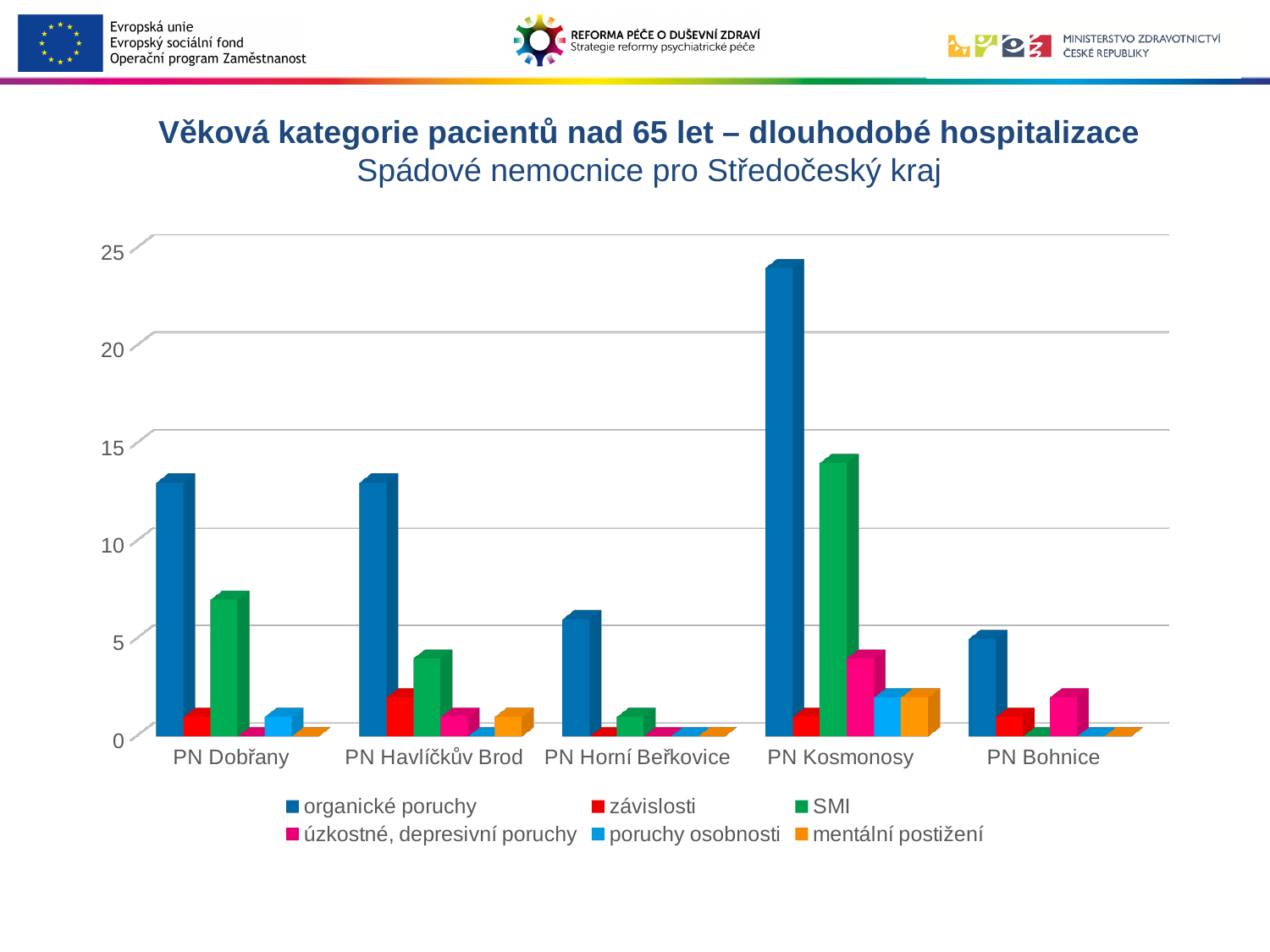
Is the value for organické poruchy at PN Dobřany greater or less than 10? greater What is the main title of the chart on the slide? Věková kategorie pacientů nad 65 let – dlouhodobé hospitalizace Is the value for organické poruchy at PN Horní Beřkovice greater or less than 10? less How many hospitals (categories) are shown on the x axis? 5 What kind of chart is shown on the slide? bar chart Which hospital has the highest value for organické poruchy? PN Kosmonosy At PN Kosmonosy, which is larger: organické poruchy or SMI? organické poruchy Is the value for SMI at PN Kosmonosy greater or less than 10? greater Which is larger: the SMI value for PN Dobřany or for PN Havlíčkův Brod? PN Dobřany How many series does the legend list? 6 Which hospital has the highest value for SMI? PN Kosmonosy